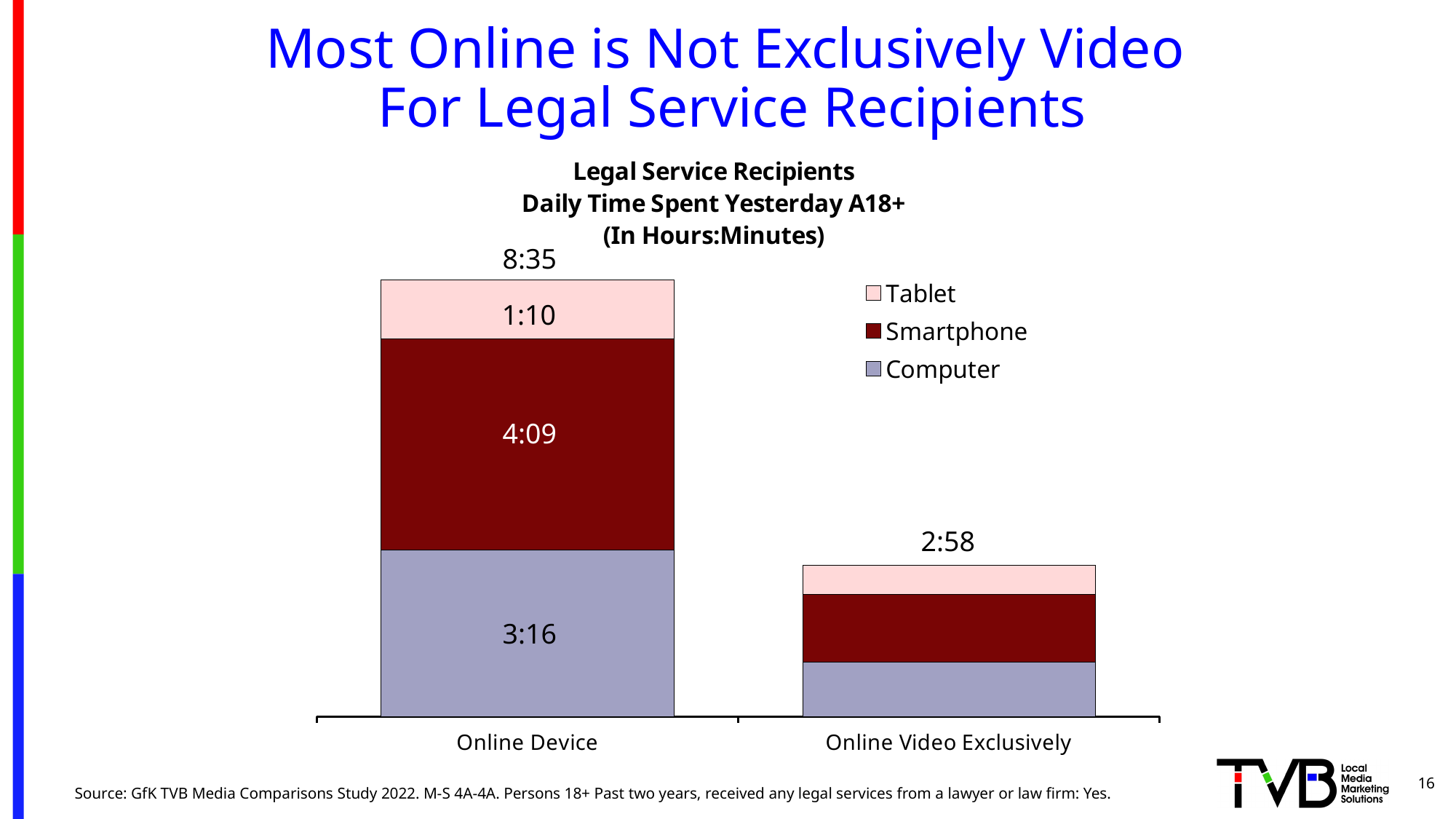
What is the Tablet value for Online Device? 1:10 What is the Smartphone value for Online Device? 4:09 What is the total daily time spent for Online Video Exclusively? 2:58 Which device accounts for the largest segment of the Online Device bar? Smartphone What is the Computer value for Online Device? 3:16 How many series does the legend list? 3 Which category has the higher total, Online Device or Online Video Exclusively? Online Device What is the total of the stacked bar for Online Device? 8:35 What kind of chart is shown on the slide? Stacked bar chart How many categories are shown on the x axis? 2 What is the difference between the Smartphone and Computer values for Online Device? 0:53 What is the difference between the Online Device total and the Online Video Exclusively total? 5:37